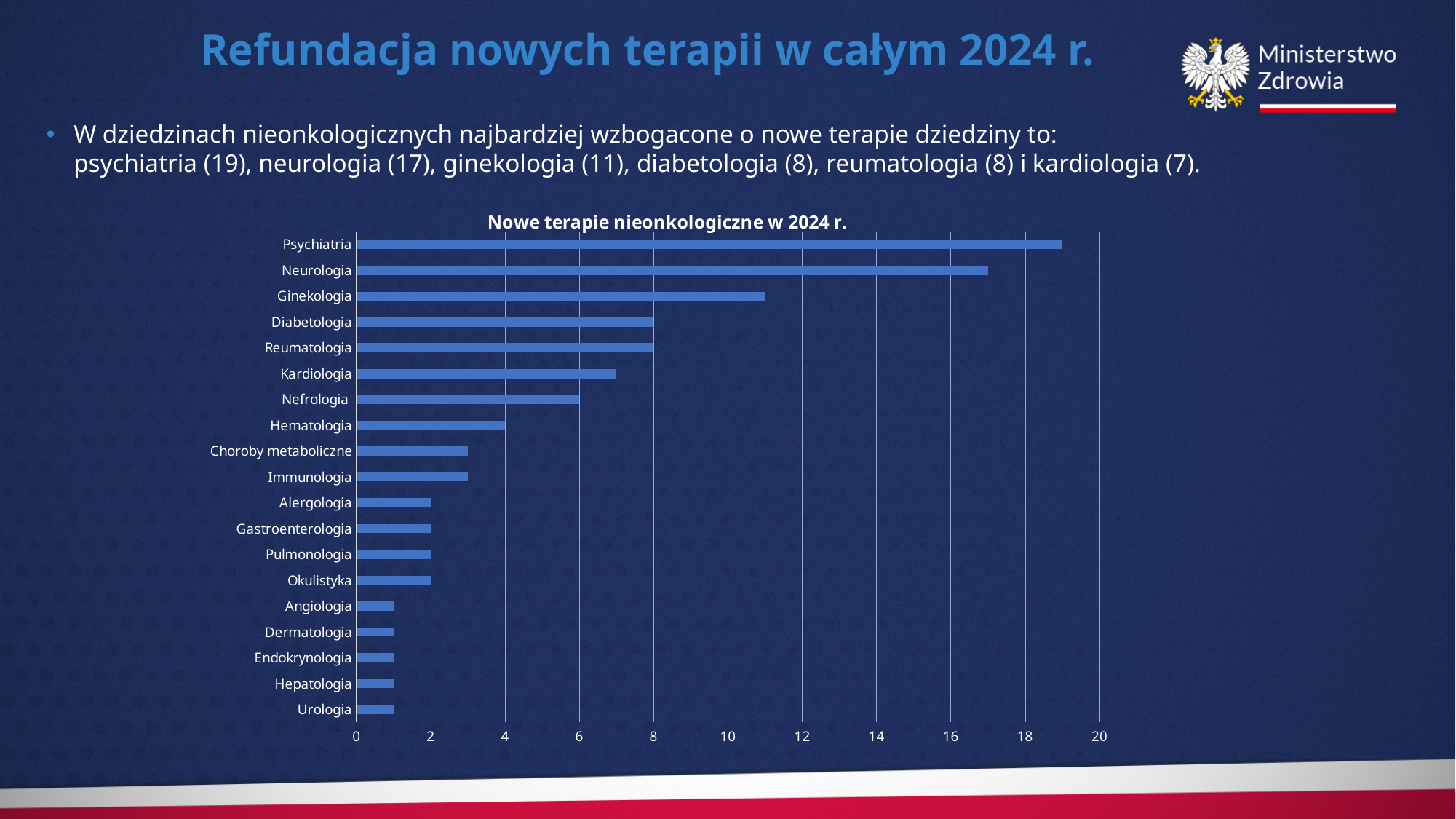
Which category has the highest value in the chart? Psychiatria Which is larger, the value for Kardiologia or the value for Nefrologia? Kardiologia What is the value for Psychiatria? 19 Is the value for Ginekologia greater or less than 10? greater Is the value for Choroby metaboliczne greater or less than 4? less What is the value for Nefrologia? 6 What is the title of the chart? Nowe terapie nieonkologiczne w 2024 r. What is the value for Neurologia? 17 How many categories (medical fields) are shown in the chart? 19 What kind of chart is shown on the slide? bar chart What is the difference between the values for Psychiatria and Ginekologia? 8 What is the value for Hematologia? 4